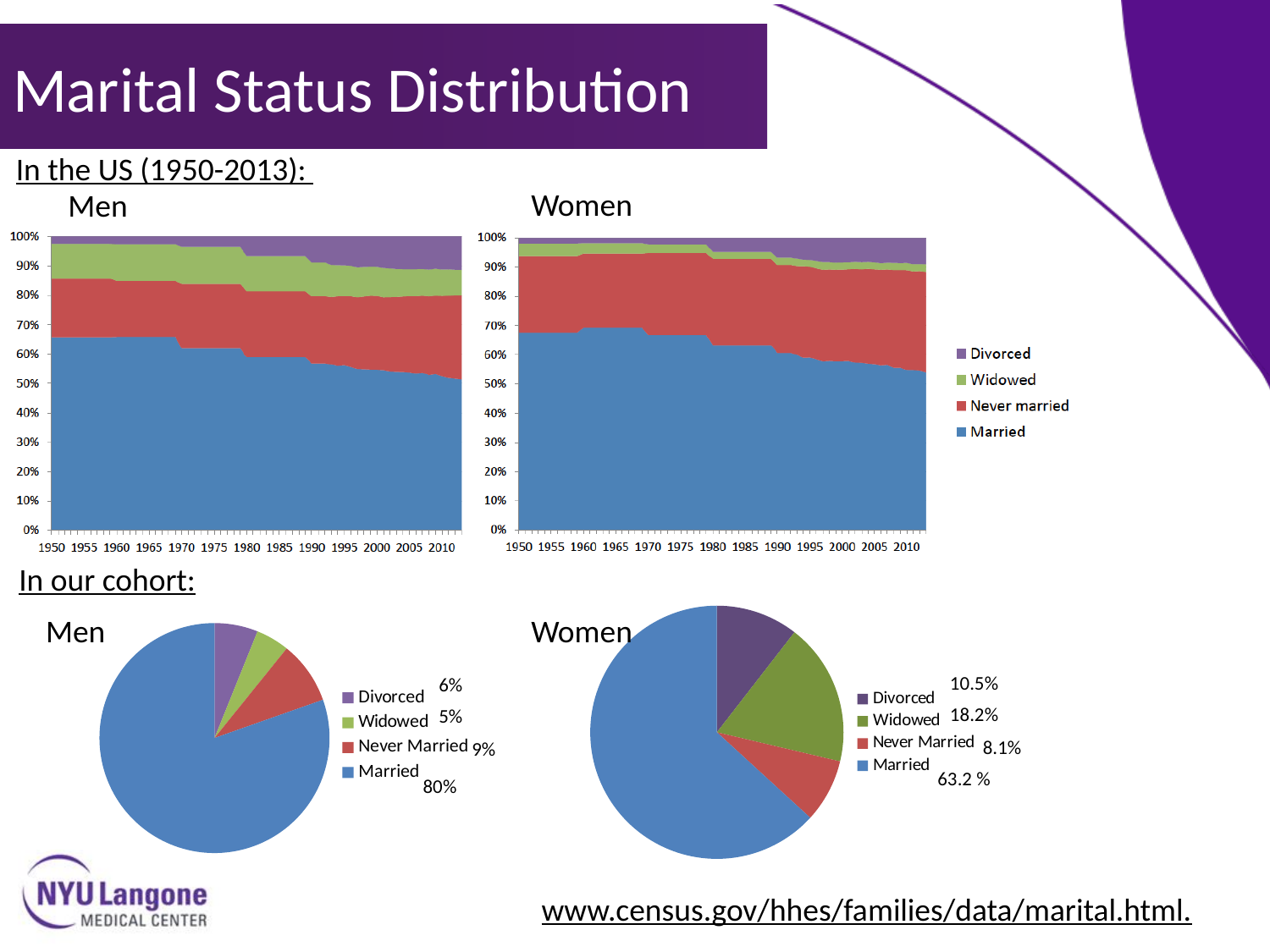
In the 'In our cohort: Men' pie chart, what percentage of men are Married? 80% How many series does the legend of the 'In the US (1950-2013)' charts list? 4 In the 'In the US (1950-2013): Men' chart, does the Married share rise or fall from 1950 to 2010? fall In the 'In our cohort: Women' pie chart, what percentage of women are Divorced? 10.5% Comparing the two cohort pie charts, is the Widowed share larger for Men or for Women? Women In the 'In our cohort: Women' pie chart, which marital status has the largest share? Married In the 'In the US (1950-2013): Women' chart, is the Married share in 1950 greater or less than 60%? greater In the 'In our cohort: Men' pie chart, which marital status has the smallest share? Widowed In the 'In our cohort: Men' pie chart, what is the difference between the Never Married share and the Divorced share? 3% In the 'In our cohort: Women' pie chart, what percentage of women are Widowed? 18.2% In the 'In our cohort: Women' pie chart, what is the difference between the Widowed share and the Never Married share? 10.1% How many marital status categories does the legend of the 'In our cohort: Men' pie chart list? 4